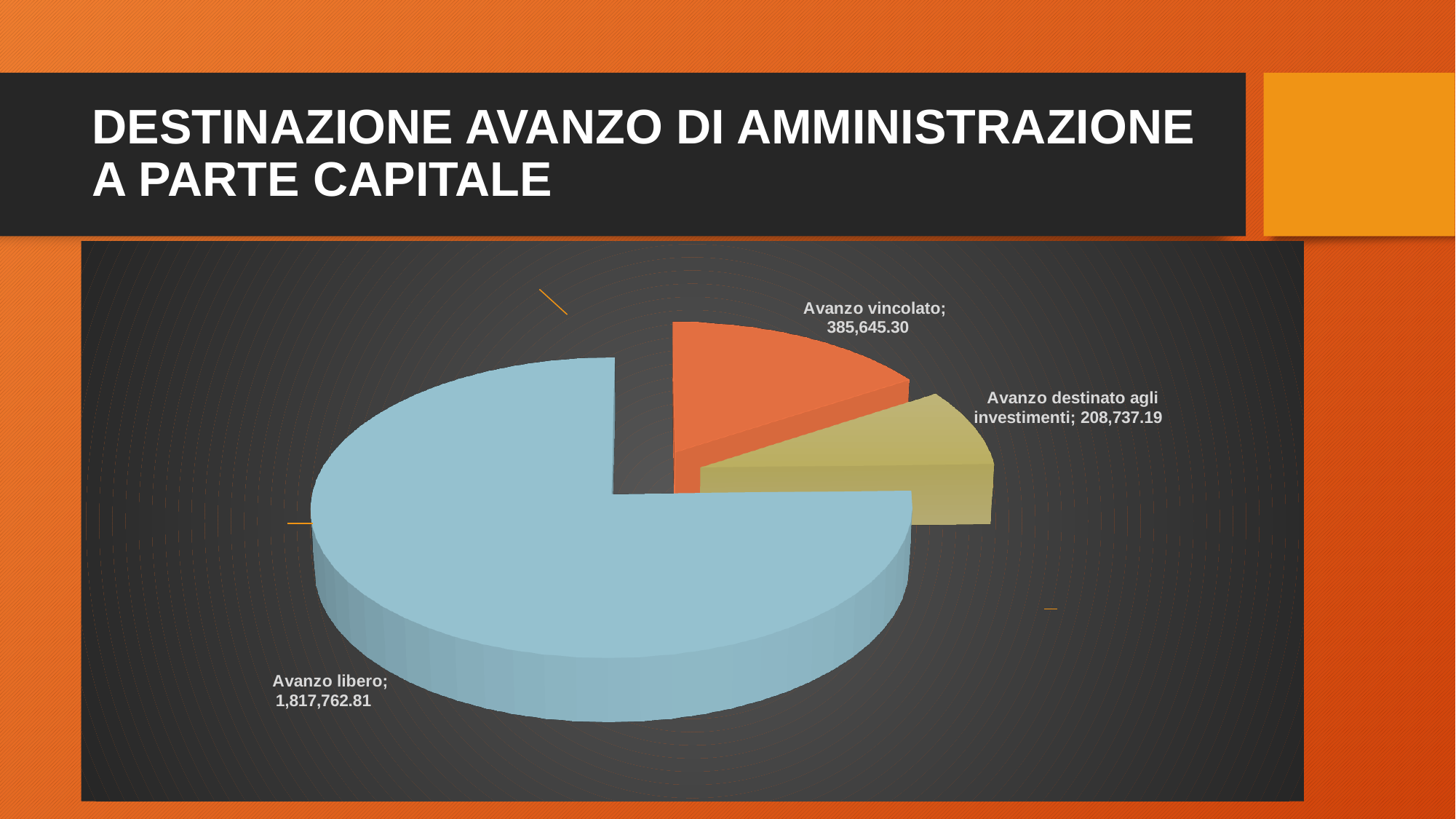
Which category has the largest slice of the pie? Avanzo libero Which is larger, Avanzo vincolato or Avanzo destinato agli investimenti? Avanzo vincolato What is the difference between Avanzo libero and Avanzo vincolato? 1,432,117.51 What is the value for Avanzo libero? 1,817,762.81 Which category has the smallest slice of the pie? Avanzo destinato agli investimenti What type of chart is shown on the slide? Pie chart What is the value for Avanzo destinato agli investimenti? 208,737.19 How many slices does the pie chart have? 3 What colour is the Avanzo libero slice? Light blue What is the total of all three slices in the pie chart? 2,412,145.30 What is the value for Avanzo vincolato? 385,645.30 What is the difference between Avanzo vincolato and Avanzo destinato agli investimenti? 176,908.11